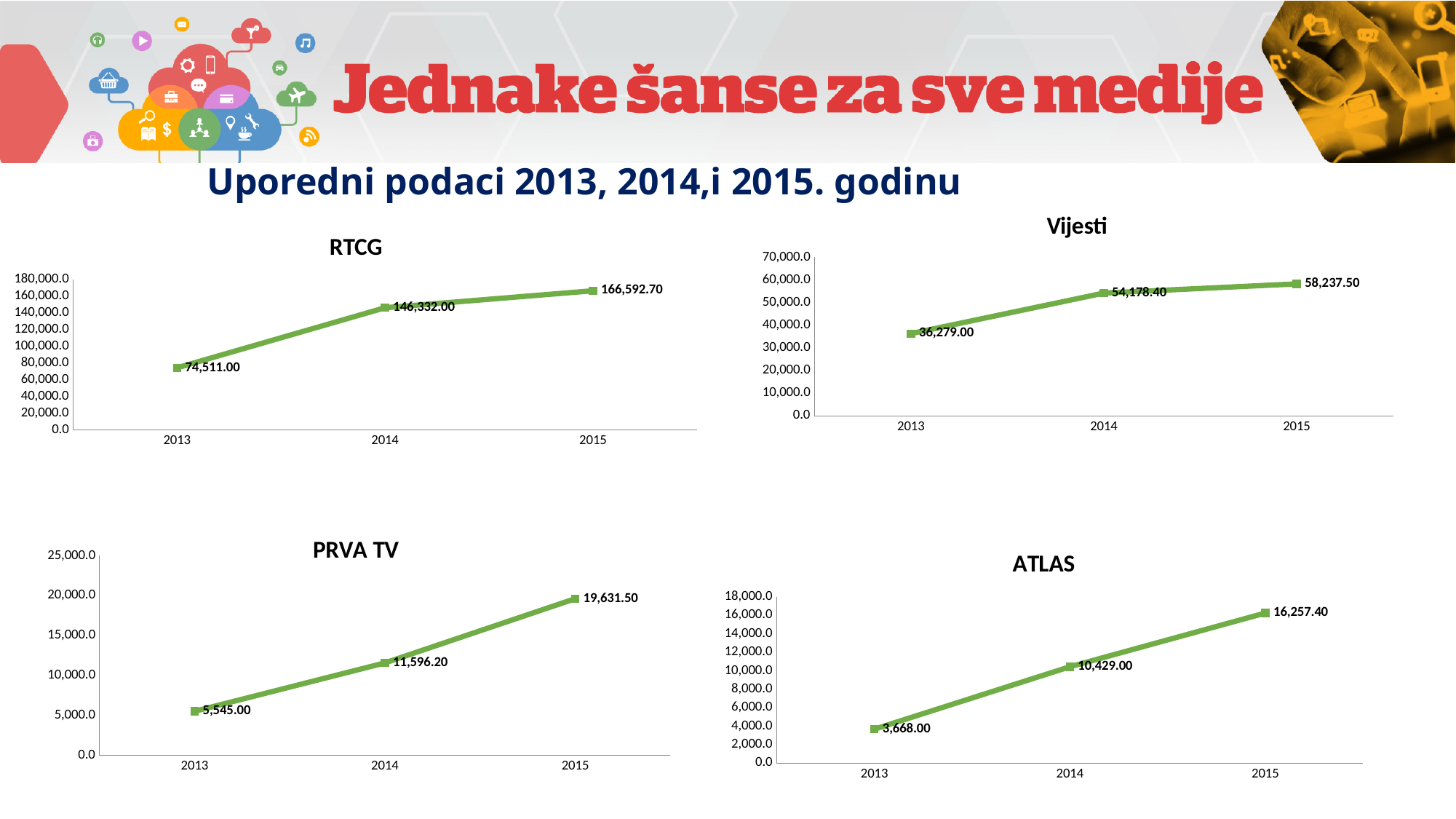
In the ATLAS chart, what is the value for 2013? 3,668.00 In the Vijesti chart, what is the difference between the 2014 and 2013 values? 17,899.40 What type of chart is the PRVA TV chart? line chart In the PRVA TV chart, which is larger, the value for 2013 or the value for 2015? 2015 In the Vijesti chart, what is the value for 2015? 58,237.50 In the RTCG chart, what is the value for 2013? 74,511.00 In the Vijesti chart, do the values rise or fall from 2013 to 2015? rise In the ATLAS chart, which year has the lowest value? 2013 In the PRVA TV chart, what is the value for 2014? 11,596.20 How many data points are plotted in the ATLAS chart? 3 In the RTCG chart, which year has the highest value? 2015 In the RTCG chart, what is the difference between the 2015 and 2013 values? 92,081.70